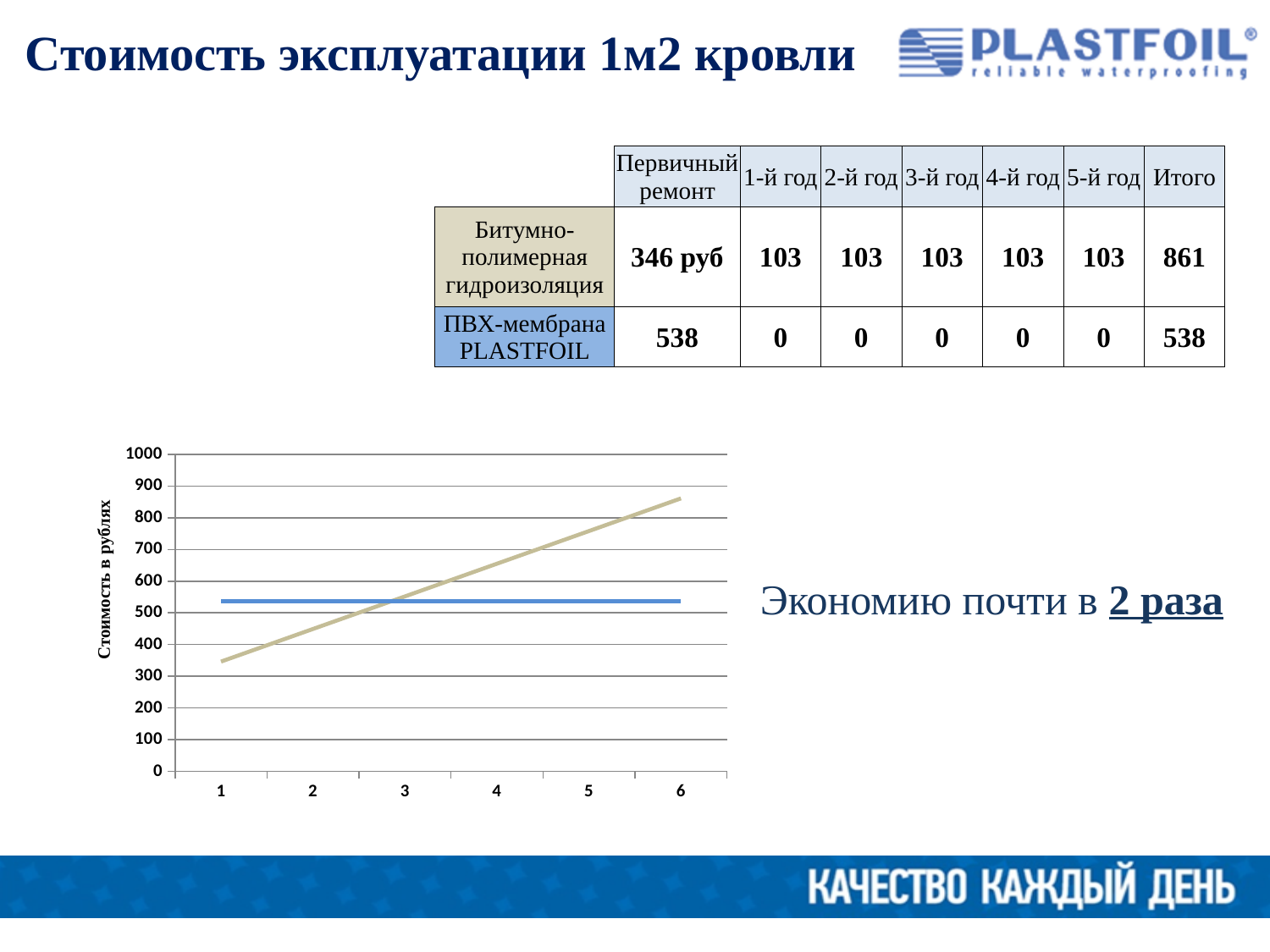
Is the value of the blue line greater or less than 500? greater What kind of chart is shown on the slide? line chart Does the blue line rise, fall or stay flat across the x axis? stays flat Is the value of the blue line greater or less than 600? less At x = 6, which line is higher, the beige line or the blue line? the beige line At x = 1, which line is higher, the beige line or the blue line? the blue line Is the value of the beige line at x = 6 greater or less than 800? greater Does the beige line rise or fall as the x axis goes from 1 to 6? rises How many points are marked along the x axis of the chart? 6 What is the title of the chart's vertical axis? Стоимость в рублях How many lines are plotted on the chart? 2